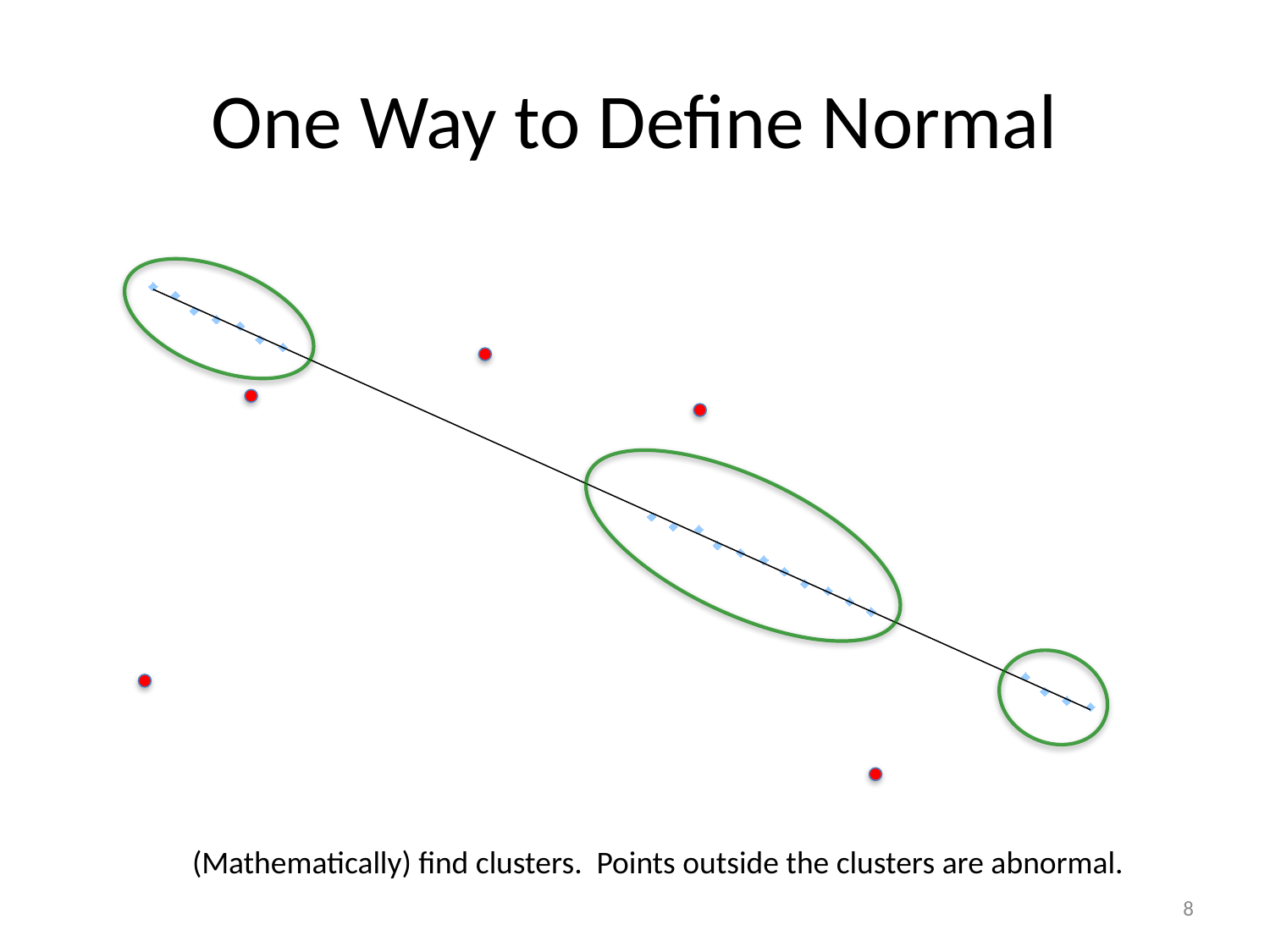
Do the blue points rise or fall from left to right along the slide? fall What kind of chart is shown on the slide? scatter chart What colour are the points that lie outside the green clusters? red How many green ellipses (clusters) are drawn on the chart? 3 How many red circular points are plotted on the chart? 5 What is the title of the slide containing the chart? One Way to Define Normal